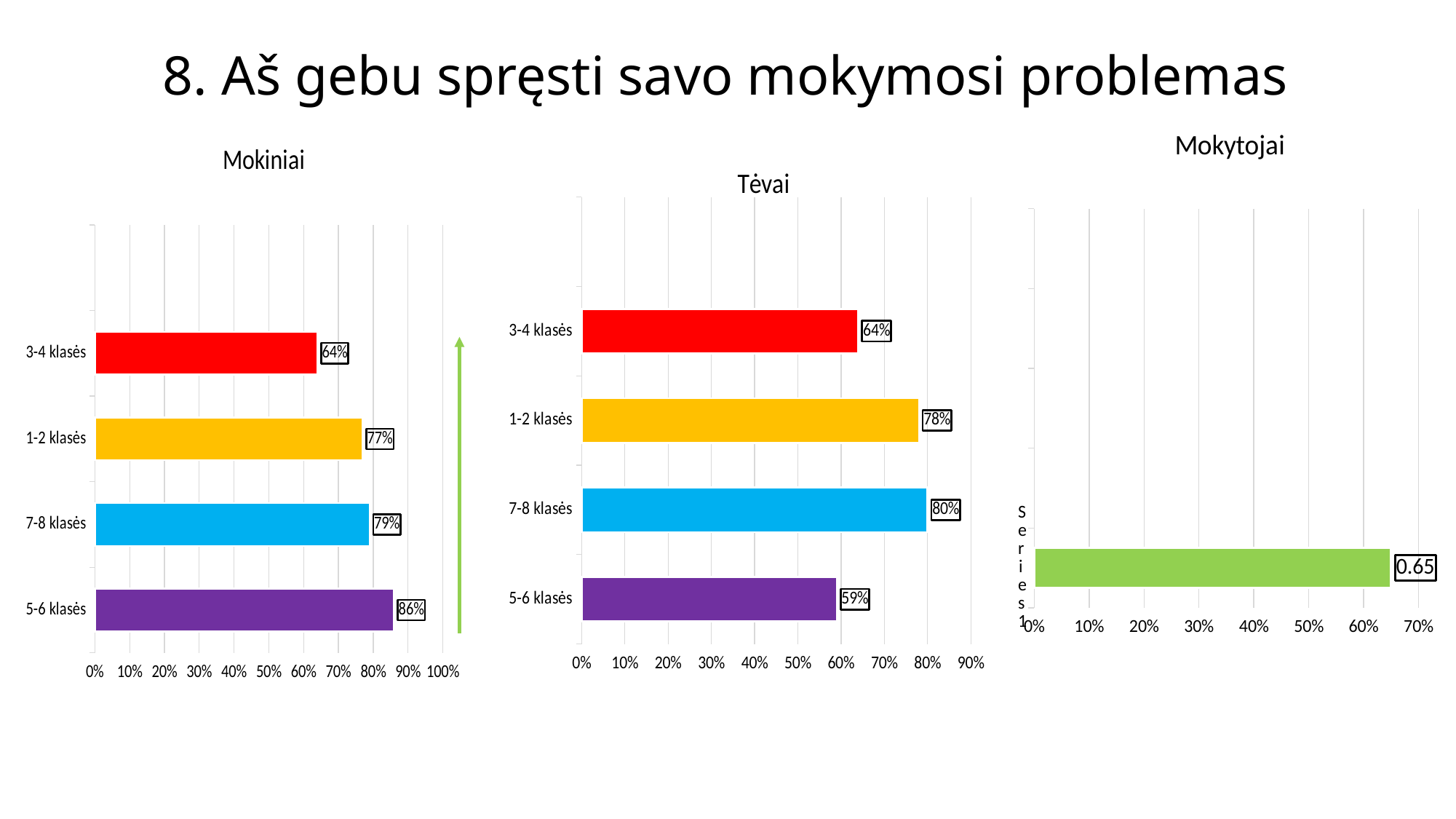
In the Tėvai chart, what is the difference between the values for 7-8 klasės and 5-6 klasės? 21% In the Mokiniai chart, how many categories are shown? 4 What kind of chart is the Mokiniai chart? bar chart In the Tėvai chart, which category has the lowest value? 5-6 klasės What is the title of the chart on the right of the slide? Mokytojai In the Mokiniai chart, what is the difference between the values for 5-6 klasės and 3-4 klasės? 22% In the Mokiniai chart, what is the value for 5-6 klasės? 86% In the Tėvai chart, which category has the highest value? 7-8 klasės In the Tėvai chart, what is the value for 1-2 klasės? 78% In the Tėvai chart, which is larger, the value for 3-4 klasės or the value for 5-6 klasės? 3-4 klasės In the Mokiniai chart, which category has the lowest value? 3-4 klasės In the Mokytojai chart, what is the data label shown on the bar? 0.65